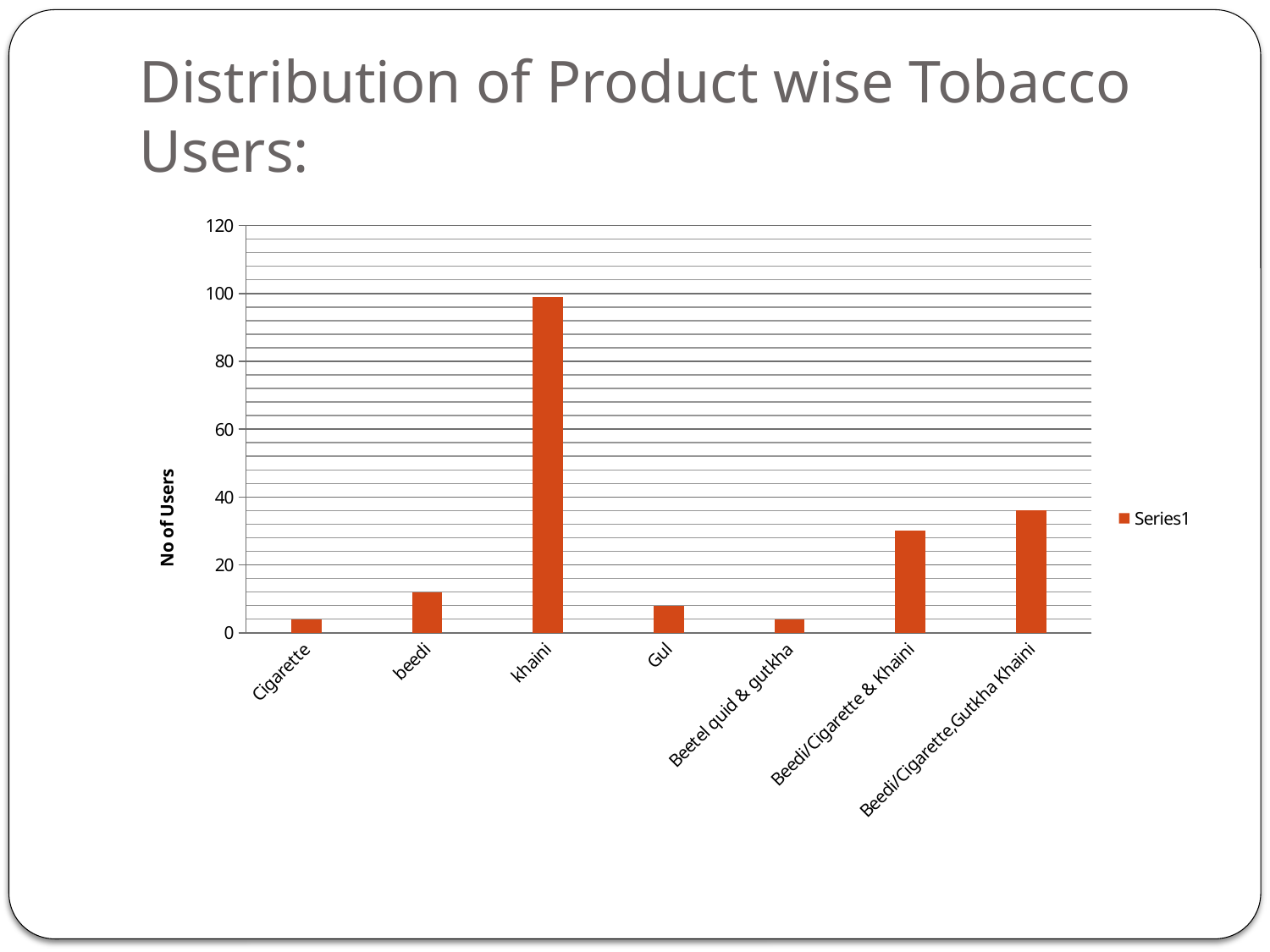
What is the name of the series shown in the legend? Series1 Is the value for Beedi/Cigarette,Gutkha Khaini greater or less than 40? less Is the value for beedi greater or less than 20? less How many series does the legend list? 1 What kind of chart is shown on the slide? bar chart Is the value for Beedi/Cigarette & Khaini greater or less than 20? greater Which product category has the highest number of users? khaini What is the label of the y axis? No of Users Which has more users, Beedi/Cigarette & Khaini or Beedi/Cigarette,Gutkha Khaini? Beedi/Cigarette,Gutkha Khaini Which has more users, Gul or beedi? beedi How many product categories are shown on the x axis? 7